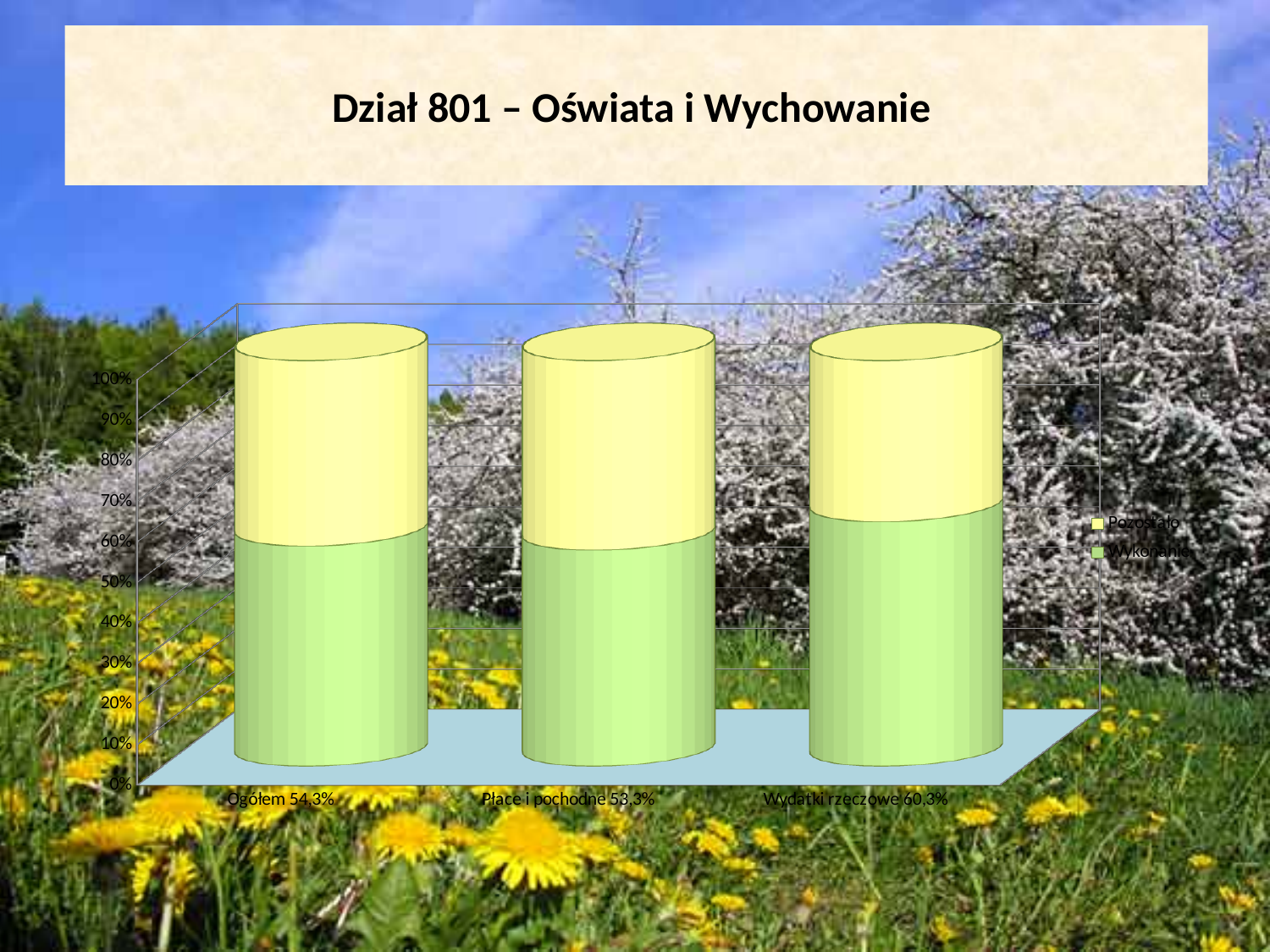
What are the two series named in the legend? Pozostało and Wykonanie What percentage is printed in the category label for Płace i pochodne? 53,3% How many series does the legend list? 2 What kind of chart is shown on the slide? bar chart What is the title of the slide? Dział 801 – Oświata i Wychowanie What percentage is printed in the category label for Wydatki rzeczowe? 60,3% Which category has the lowest percentage printed in its label? Płace i pochodne Is the Wykonanie portion of the Wydatki rzeczowe bar greater or less than 50%? greater What percentage is printed in the category label for Ogółem? 54,3% Which category has the highest percentage printed in its label? Wydatki rzeczowe Which is larger, the percentage for Wydatki rzeczowe or for Płace i pochodne? Wydatki rzeczowe How many categories are shown on the x axis? 3